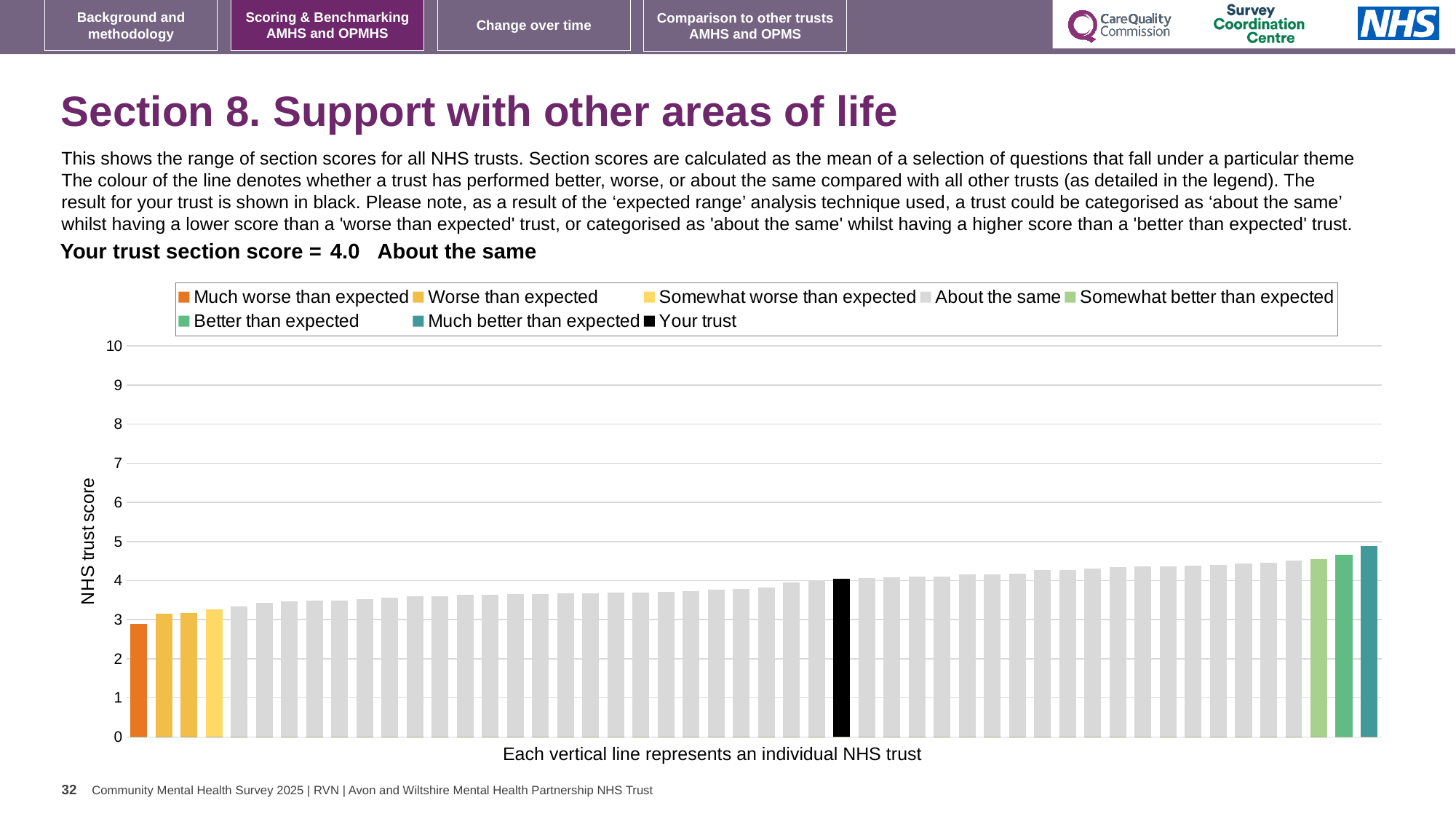
Is the value of the black 'Your trust' bar greater or less than 5? less What is the section score for your trust shown on the slide? 4.0 How many entries does the chart legend list? 8 Which category is your trust placed in for this section? About the same Is the value of the rightmost bar greater or less than 4? greater Do the bar values rise or fall from left to right along the x axis? rise What kind of chart is shown on the slide? bar chart Which legend category does the lowest bar on the chart belong to? Much worse than expected Is the value of the leftmost (orange) bar greater or less than 4? less Which legend category does the highest bar on the chart belong to? Much better than expected What is the label on the vertical axis of the chart? NHS trust score